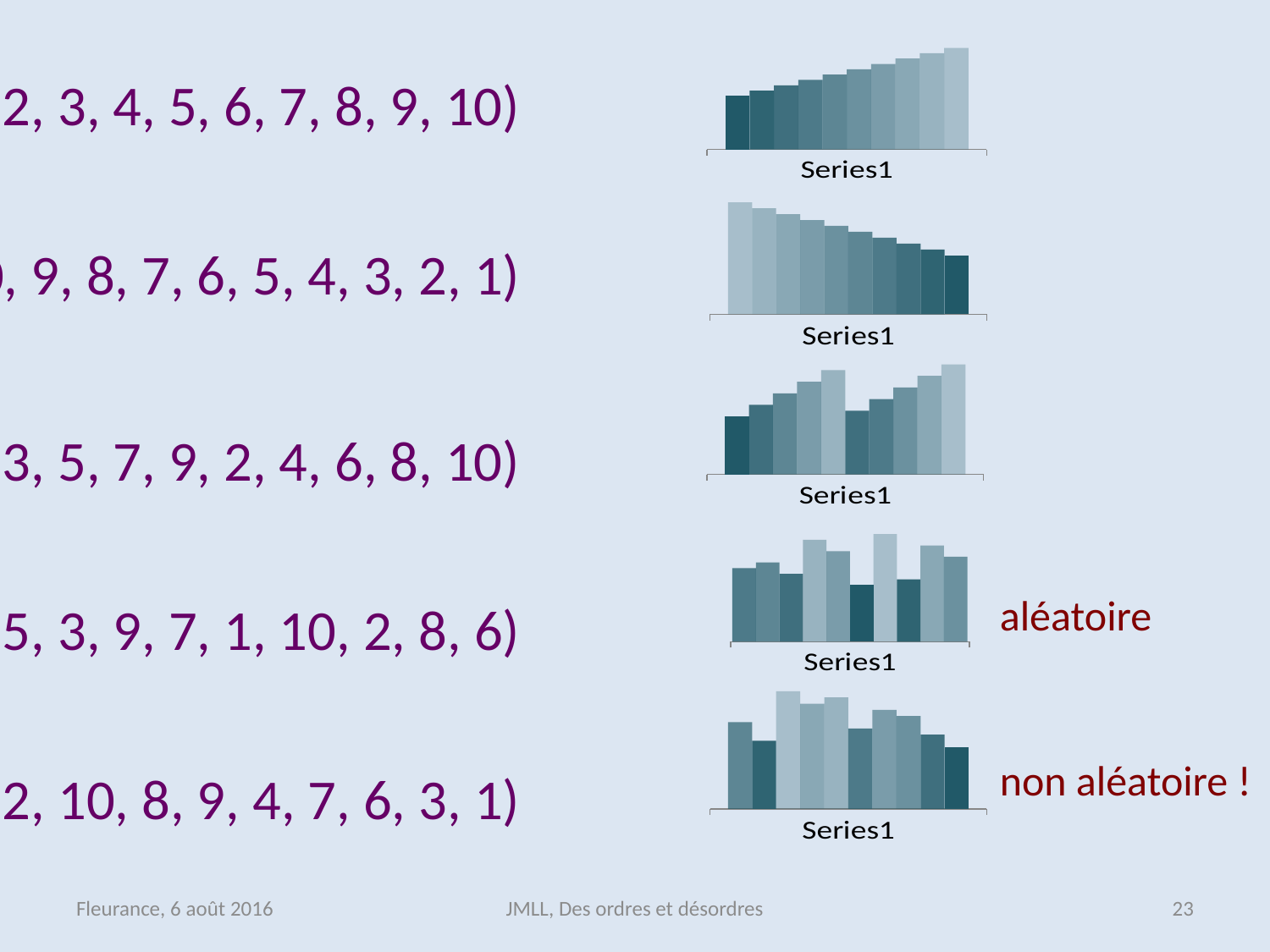
How many bars does the bottom chart contain? 10 How many bars does the top chart contain? 10 In the top chart, which bar is taller, the leftmost or the rightmost? rightmost What kind of chart is the top chart on the slide? bar chart What label appears beneath each of the charts? Series1 Which chart is annotated with the word 'aléatoire'? the fourth chart from the top In the second chart from the top, do the bar heights rise or fall from left to right? fall In the second chart from the top, which bar is taller, the leftmost or the rightmost? leftmost How many charts are shown on the slide? 5 In the top chart, do the bar heights rise or fall from left to right? rise